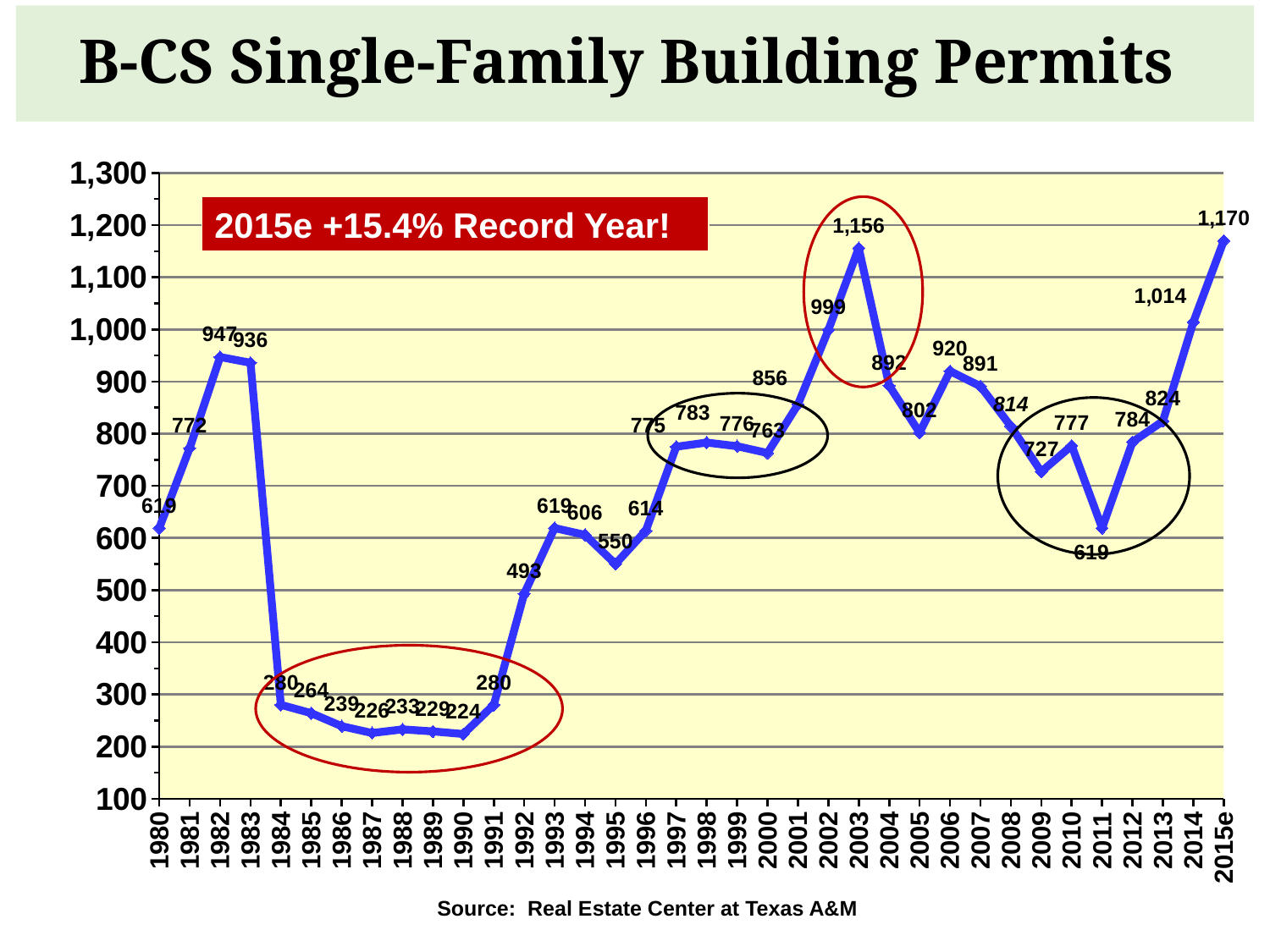
Do the values rise or fall from 2011 to 2015e? Rise Which year has the highest number of building permits? 2015e How many single-family building permits were issued in 2003? 1,156 What is the source cited below the chart? Real Estate Center at Texas A&M What is the value for 1982? 947 Which year has the lowest number of building permits? 1990 What is the value for 1990? 224 What is the difference between the values for 2015e and 2014? 156 What is the value for 2014? 1,014 Which year has the larger value, 2006 or 2007? 2006 How many years (data points) are plotted on the chart? 36 What type of chart is shown on the slide? Line chart